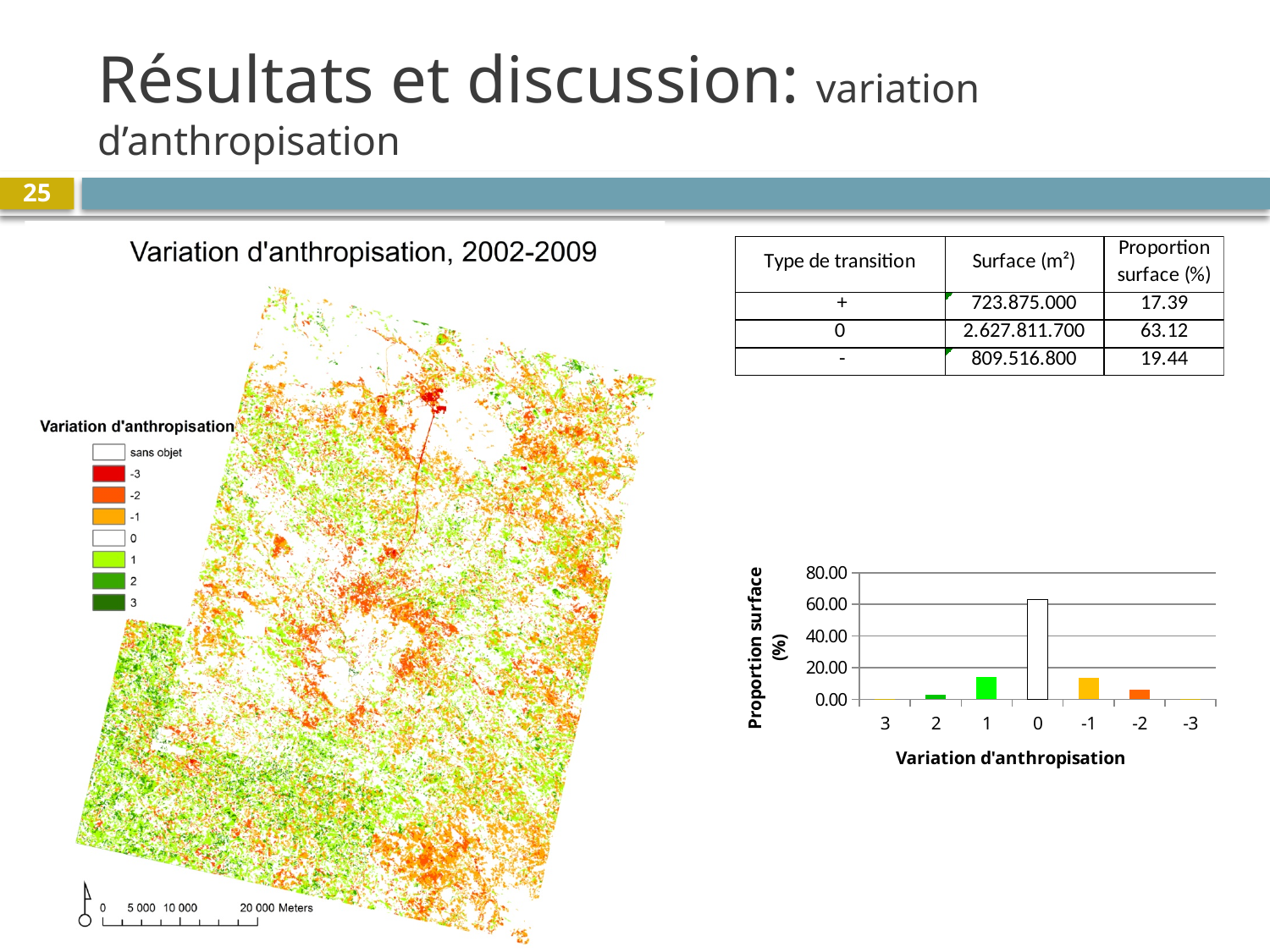
What kind of chart is shown at the bottom right of the slide? bar chart In the bar chart, is the value for category 0 greater or less than 80.00? less In the bar chart, which is larger, the value for category -2 or the value for category 2? -2 In the bar chart, is the value for category -2 greater or less than 20.00? less What is the title of the y axis of the bar chart? Proportion surface (%) In the bar chart, how many categories are shown on the x axis? 7 In the bar chart, which category has the highest proportion surface? 0 In the bar chart, which is larger, the value for category 1 or the value for category 2? 1 In the bar chart, is the value for category 0 greater or less than 40.00? greater What is the title of the x axis of the bar chart? Variation d'anthropisation In the bar chart, do the values rise or fall going from category 0 to category -3? fall